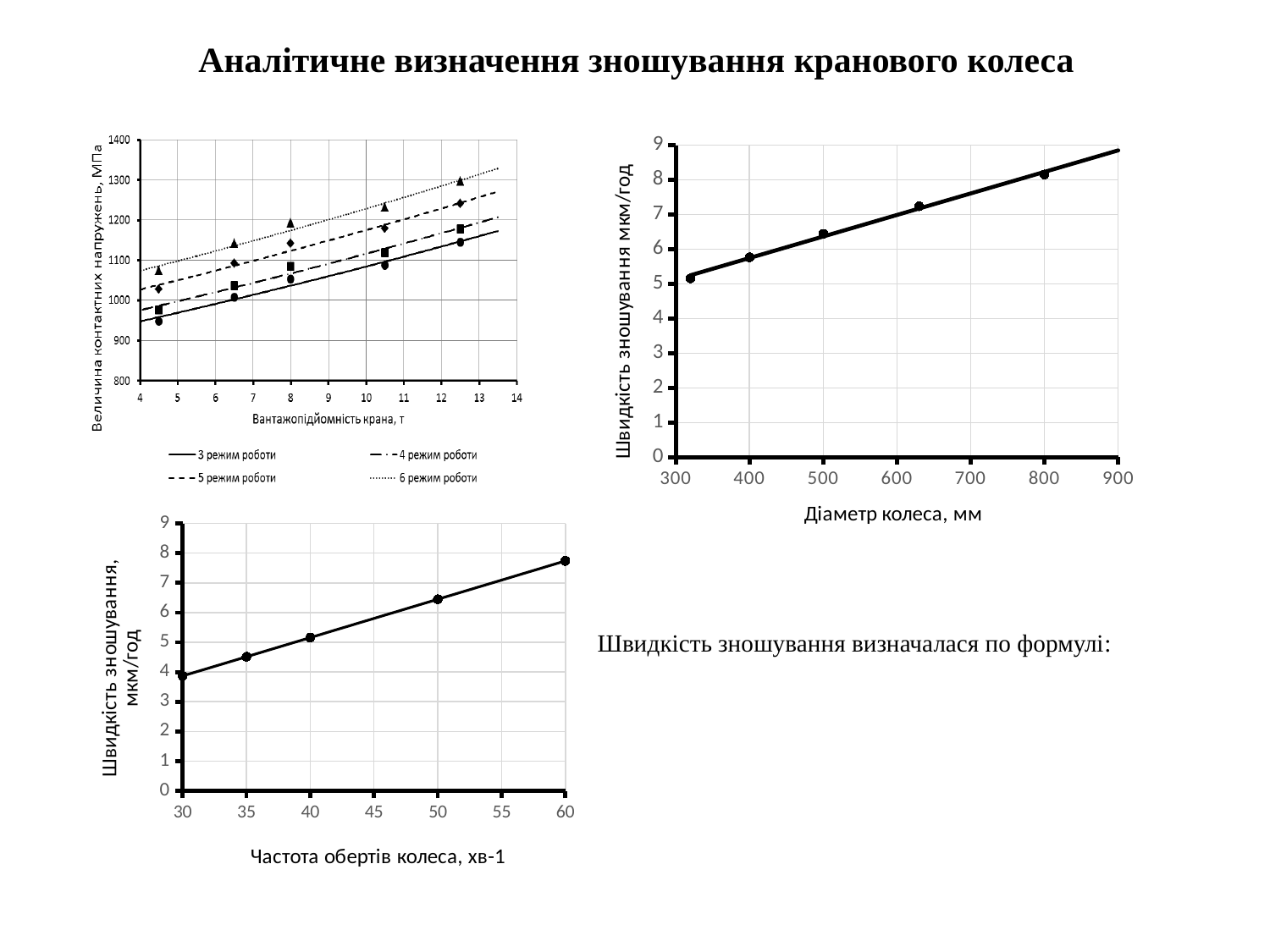
In the top-right chart (wear rate vs wheel diameter), does the wear rate rise or fall as the wheel diameter increases? rise In the bottom-left chart (wear rate vs wheel rotation frequency), how many data points are plotted? 5 In the bottom-left chart (wear rate vs wheel rotation frequency), is the wear rate at 60 хв-1 greater or less than 7? greater In the top-right chart (wear rate vs wheel diameter), is the wear rate at a diameter of 800 mm greater or less than 7? greater In the top-left chart, which series has the highest contact stress values? 6 режим роботи In the bottom-left chart (wear rate vs wheel rotation frequency), is the wear rate at 30 хв-1 greater or less than 5? less In the top-left chart, what is the title of the x axis? Вантажопідйомність крана, т In the top-left chart, how many series does the legend list? 4 In the top-left chart, which series has the lowest contact stress values? 3 режим роботи In the top-right chart (wear rate vs wheel diameter), how many data points are plotted? 5 In the top-left chart, do the contact stress values rise or fall as crane load capacity increases along the x axis? rise